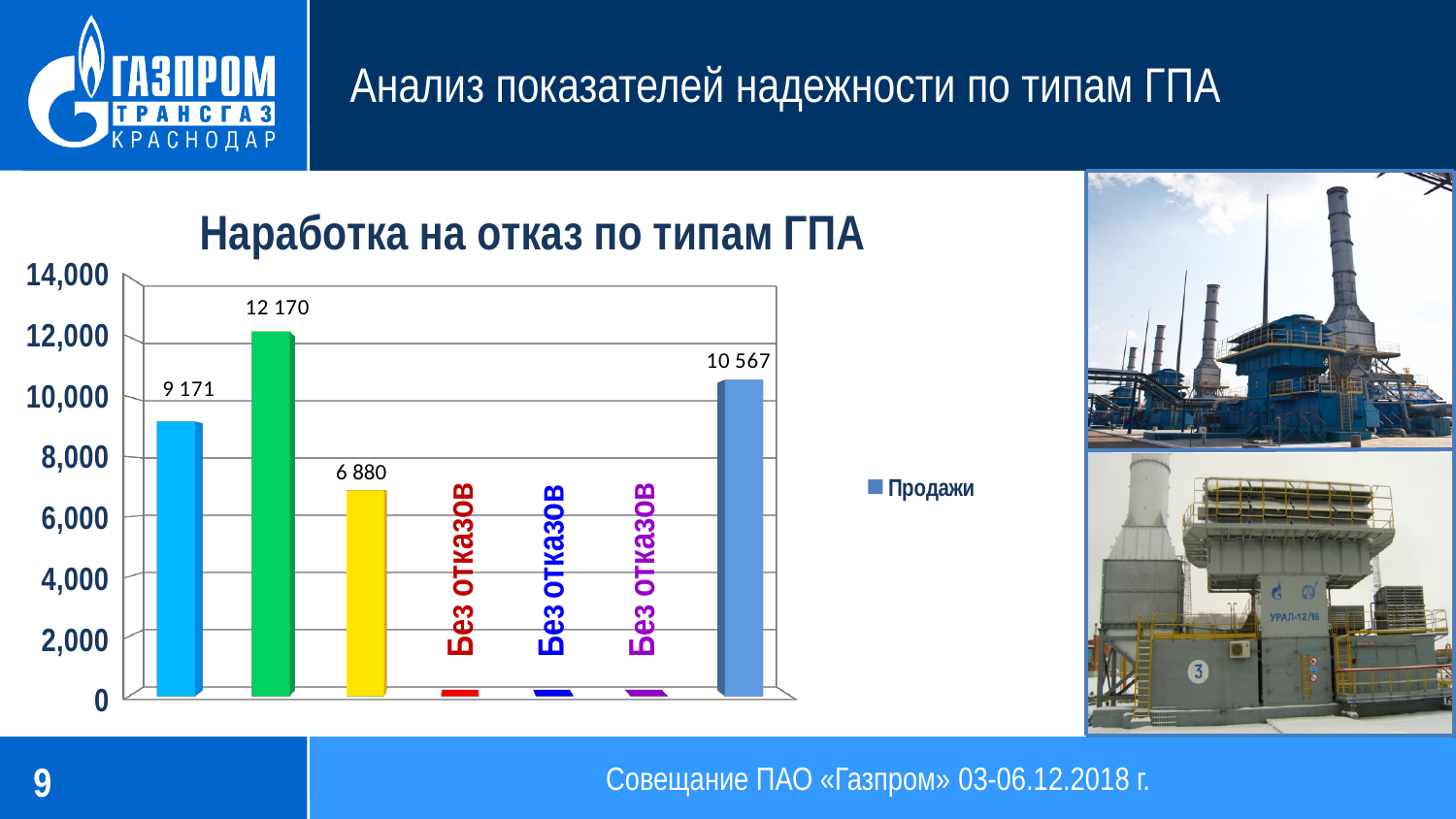
What is the value of the yellow bar? 6 880 What is the value of the last bar on the right? 10 567 What is the difference between the green bar (12 170) and the first light blue bar (9 171)? 2 999 What is the title of the chart? Наработка на отказ по типам ГПА Which is larger: the first bar on the left or the last bar on the right? the last bar on the right (10 567) What kind of chart is shown on the slide? bar chart How many series does the chart legend list? 1 Which bar has the highest value in the chart? the green bar (12 170) How many bars are plotted in the chart? 7 What is the value of the first (light blue) bar on the left? 9 171 What is the legend entry of the chart? Продажи What is the value of the green bar (second from the left)? 12 170